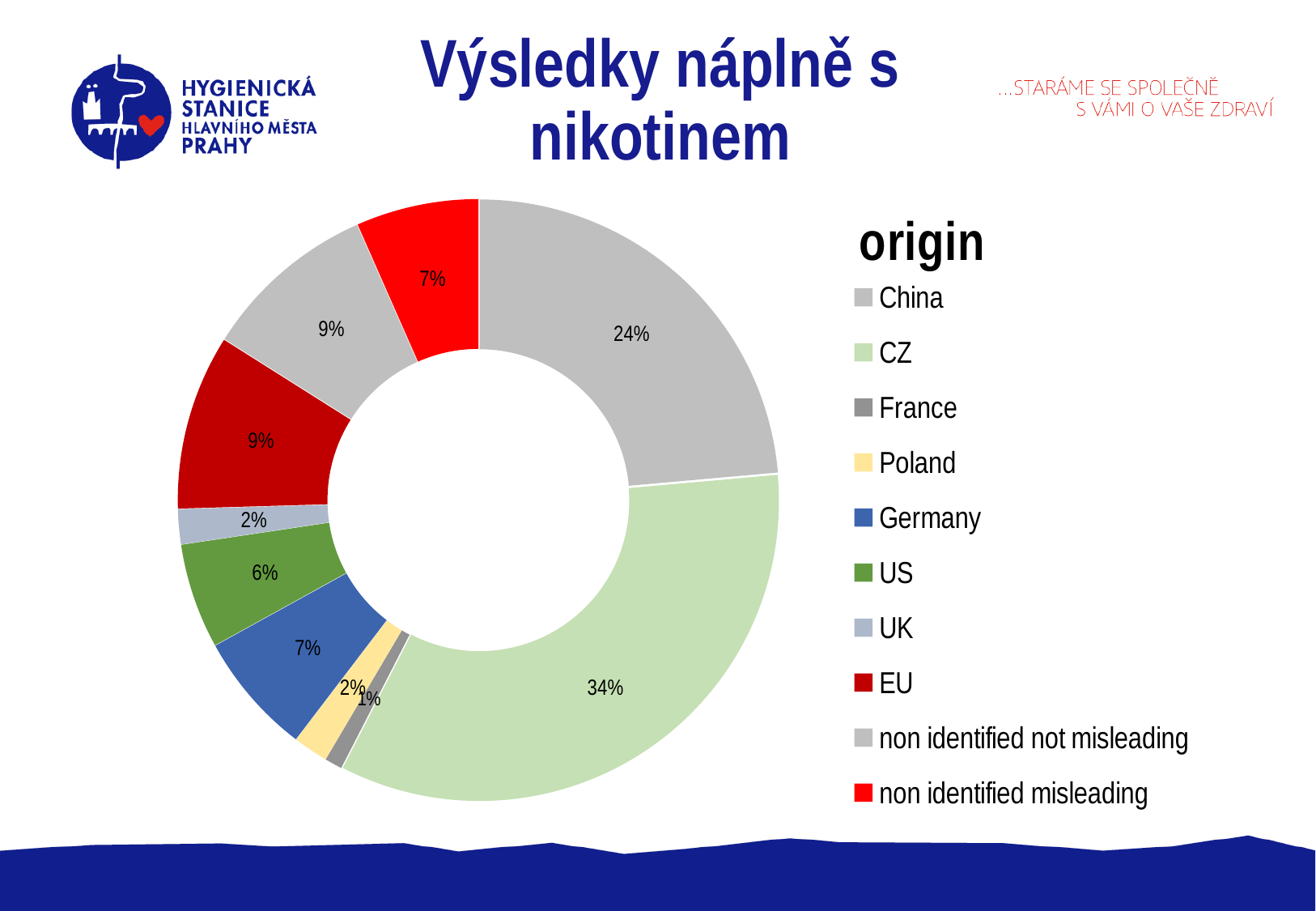
Which is larger, the share for Germany or the share for US? Germany What is the value for US? 6% Which category has the smallest share of the chart? France What is the value shown for China? 24% By how many percentage points does CZ exceed China? 10 percentage points What kind of chart is shown on the slide? Doughnut (pie) chart How many categories does the legend list? 10 What percentage is shown for Germany? 7% What is the title of the chart? origin What percentage is shown for EU? 9% What share of the pie does CZ account for? 34% Which category has the largest share of the chart? CZ